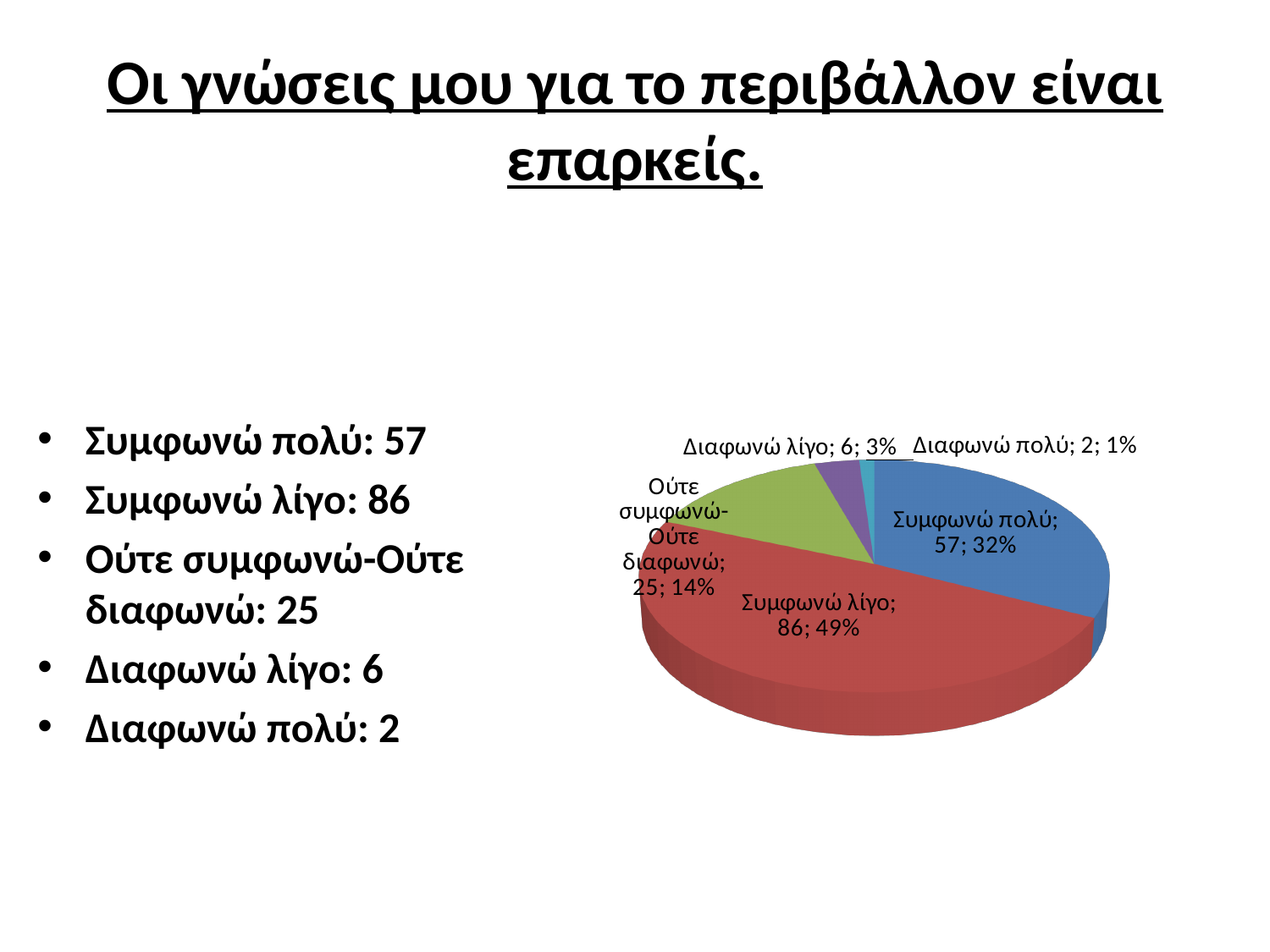
What is the value for Ούτε συμφωνώ-Ούτε διαφωνώ in the pie chart? 25 What is the value for Συμφωνώ λίγο in the pie chart? 86 Which is larger, the value for Ούτε συμφωνώ-Ούτε διαφωνώ or the value for Διαφωνώ λίγο? Ούτε συμφωνώ-Ούτε διαφωνώ What is the difference between the values for Συμφωνώ λίγο and Συμφωνώ πολύ? 29 What kind of chart is shown on the slide? pie chart What is the value for Συμφωνώ πολύ in the pie chart? 57 What share of the pie does Διαφωνώ λίγο represent? 3% Which category has the smallest slice in the pie chart? Διαφωνώ πολύ What is the value for Διαφωνώ πολύ in the pie chart? 2 What share of the pie does Συμφωνώ λίγο represent? 49% Which category has the largest slice in the pie chart? Συμφωνώ λίγο How many slices does the pie chart have? 5